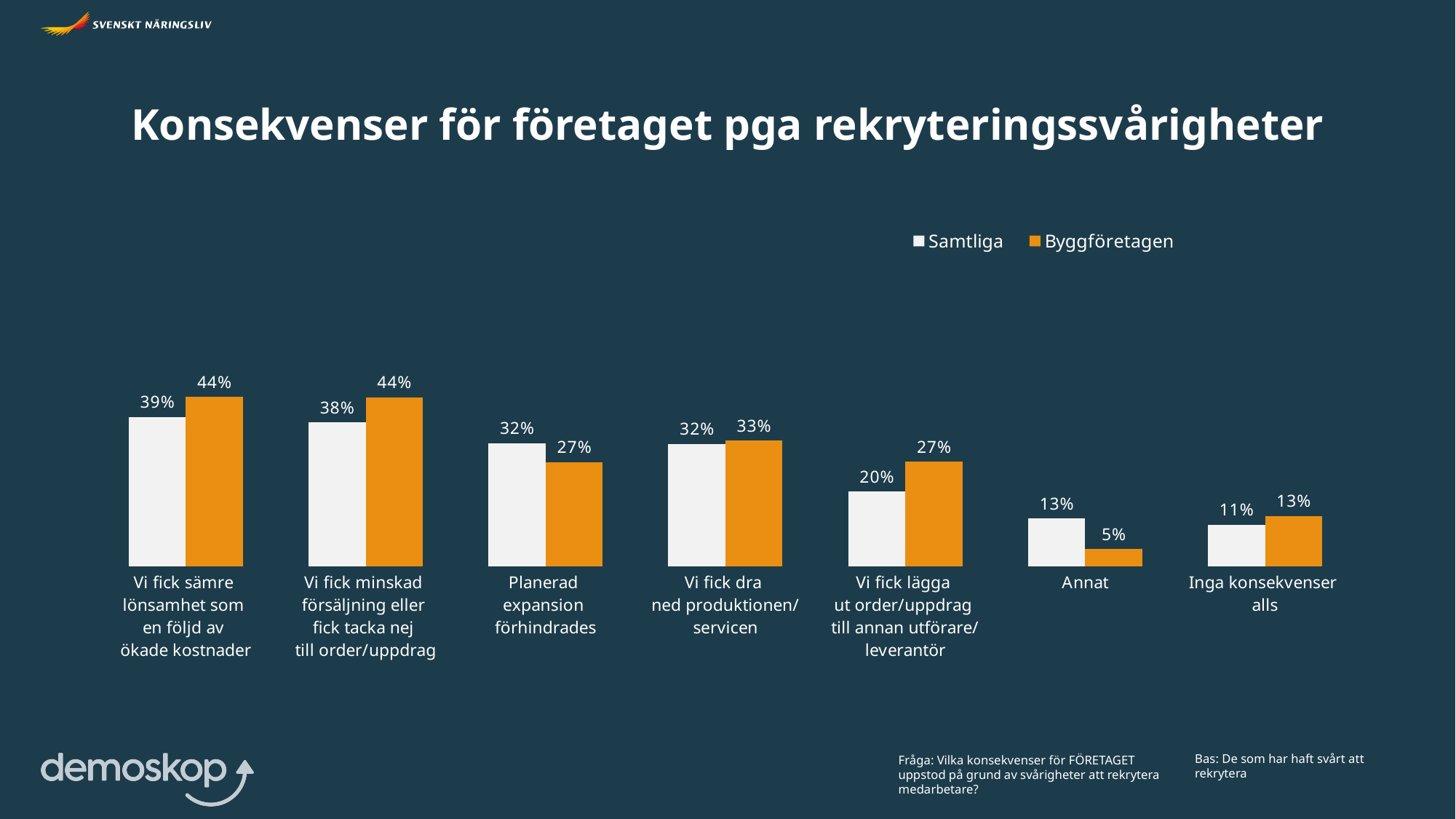
What is the value for Samtliga for 'Inga konsekvenser alls'? 11% How many categories are shown on the x axis? 7 What is the difference between Byggföretagen and Samtliga for 'Vi fick lägga ut order/uppdrag till annan utförare/leverantör'? 7% How many series does the legend list? 2 What kind of chart is shown on the slide? Bar chart What is the value for Byggföretagen for 'Planerad expansion förhindrades'? 27% Which category has the lowest value for Byggföretagen? Annat What is the difference between Samtliga and Byggföretagen for 'Annat'? 8% For 'Planerad expansion förhindrades', which series has the larger value, Samtliga or Byggföretagen? Samtliga What is the value for Samtliga for 'Vi fick lägga ut order/uppdrag till annan utförare/leverantör'? 20% What is the value for Byggföretagen for 'Annat'? 5% Which category has the highest value for Samtliga? Vi fick sämre lönsamhet som en följd av ökade kostnader